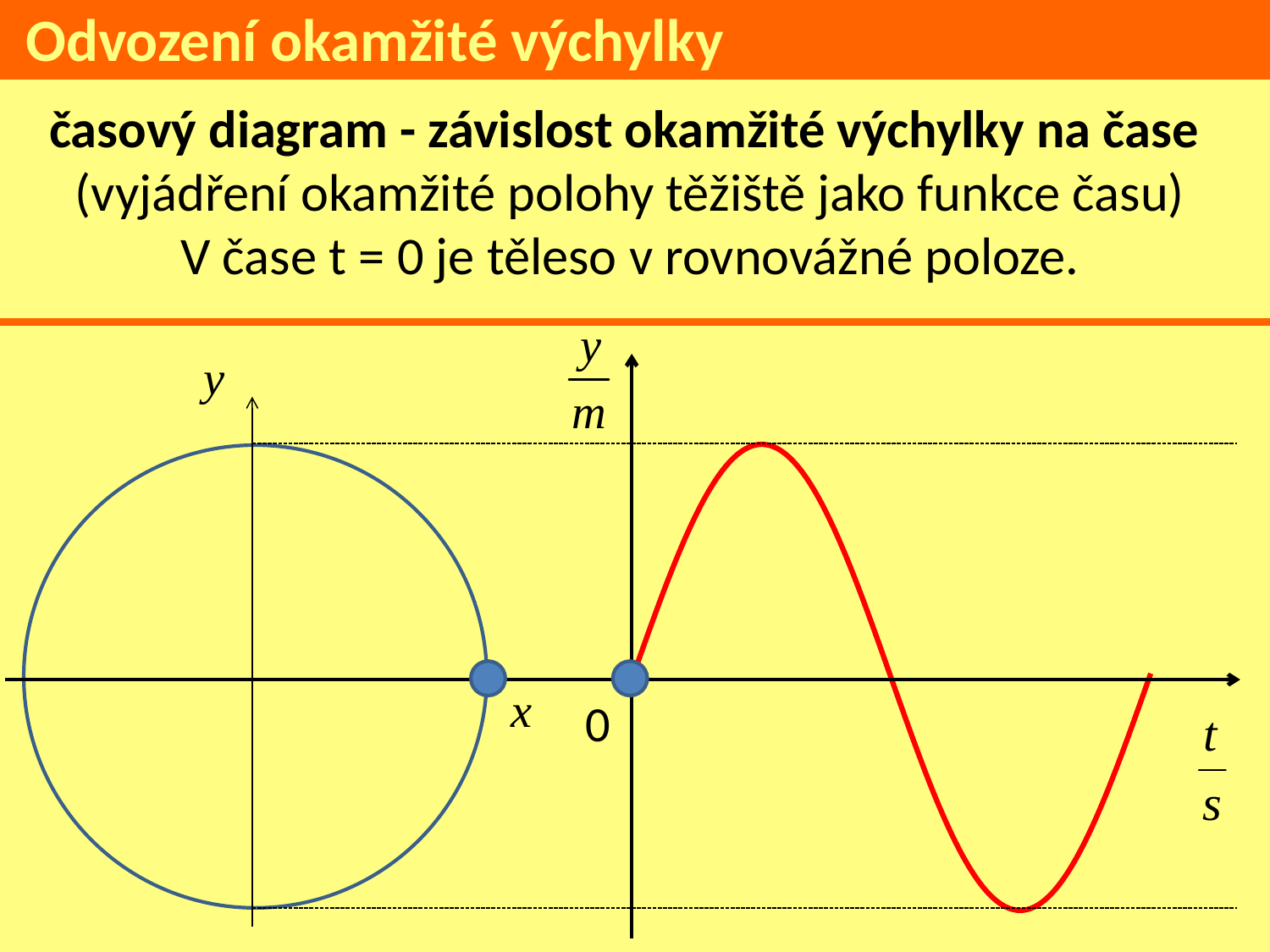
How many complete oscillations (periods) of the red curve are shown on the time diagram? 1 What label is written on the horizontal axis of the time diagram on the right? t/s Does the red curve rise or fall immediately after t = 0 on the time diagram? rise What colour is the curve plotted on the time diagram on the right? red What is the value of the red curve at t = 0 on the time diagram? 0